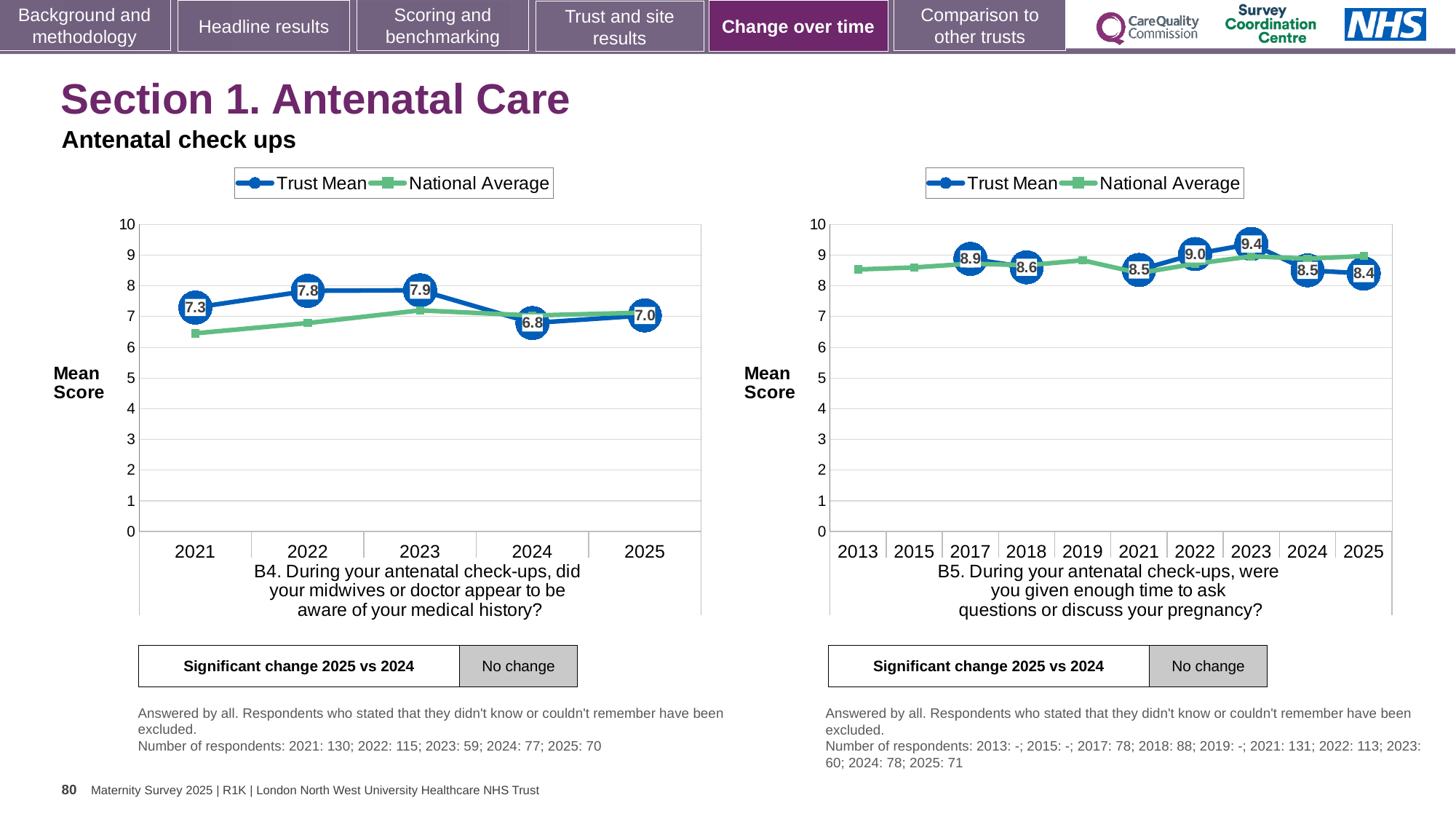
In the right chart (B5), which year has the highest Trust Mean score? 2023 In the right chart (B5), is the Trust Mean score for 2022 or 2018 larger? 2022 In the right chart (B5), is the National Average for 2013 greater or less than 8? greater In the right chart (B5), what is the Trust Mean score for 2023? 9.4 In the left chart (B4), how many years are shown on the x axis? 5 In the left chart (B4), what is the Trust Mean score for 2024? 6.8 In the left chart (B4), which year has the lowest Trust Mean score? 2024 In the left chart (B4), what is the difference between the Trust Mean scores for 2023 and 2024? 1.1 What type of chart is the left chart (B4)? Line chart In the right chart (B5), what is the Trust Mean score for 2025? 8.4 In the left chart (B4), which year has the highest Trust Mean score? 2023 In the left chart (B4), what is the Trust Mean score for 2023? 7.9